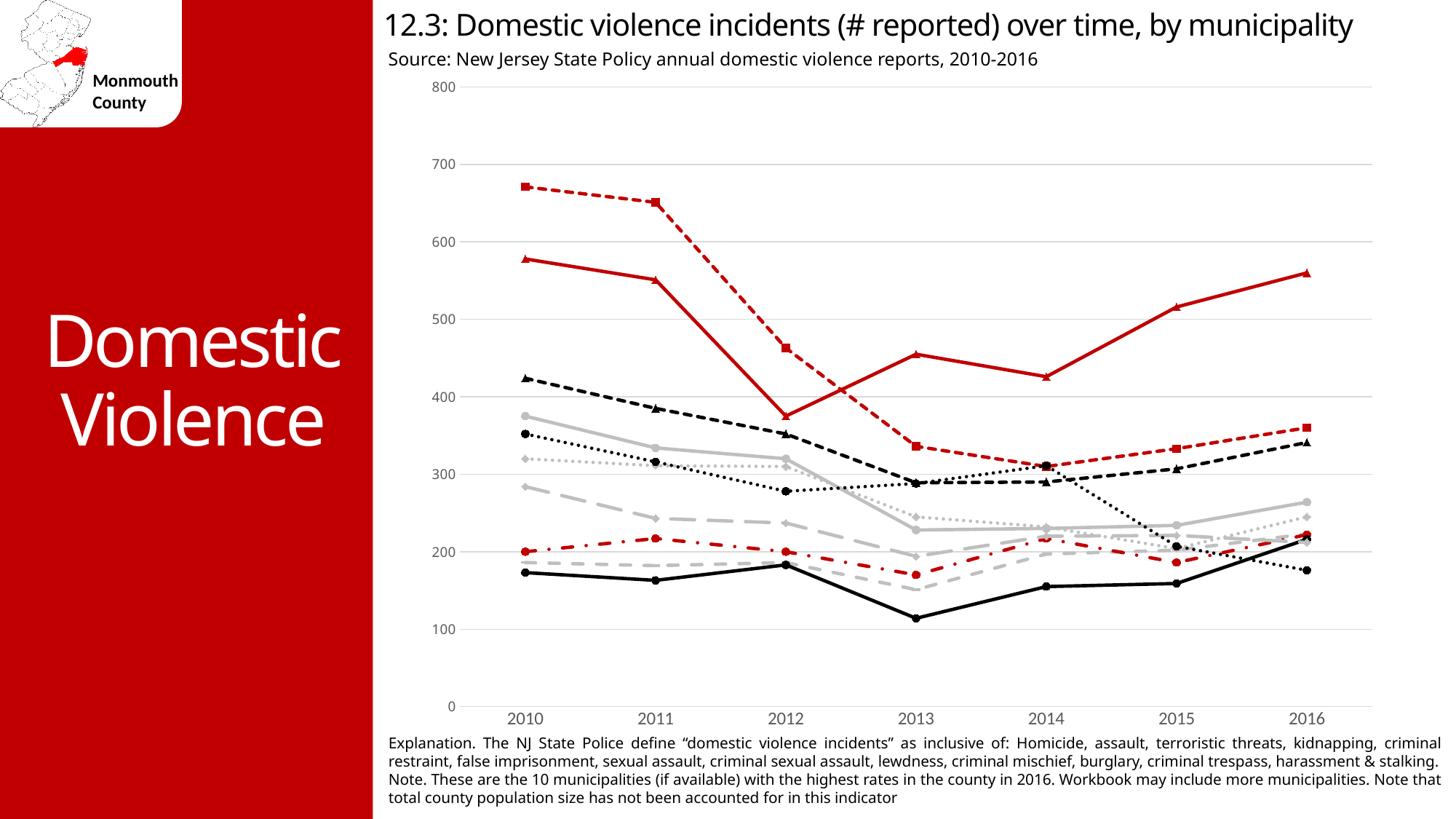
Is the value of the black dotted line with circle markers in 2016 greater or less than 200? less What is the highest value shown on the chart's vertical axis? 800 In which year does the red dashed line with square markers reach its highest value? 2010 What is the title of the chart on the slide? 12.3: Domestic violence incidents (# reported) over time, by municipality Is the value of the solid black line with circle markers in 2013 greater or less than 200? less In 2010, which line is higher: the red dashed line with square markers or the solid red line with triangle markers? The red dashed line with square markers Is the value of the solid red line with triangle markers in 2016 greater or less than 500? greater What kind of chart is shown on the slide? Line chart Does the red dashed line with square markers rise or fall from 2010 to 2013? Fall Which line has the highest value in 2016? The solid red line with triangle markers How many years are plotted along the x axis of the chart? 7